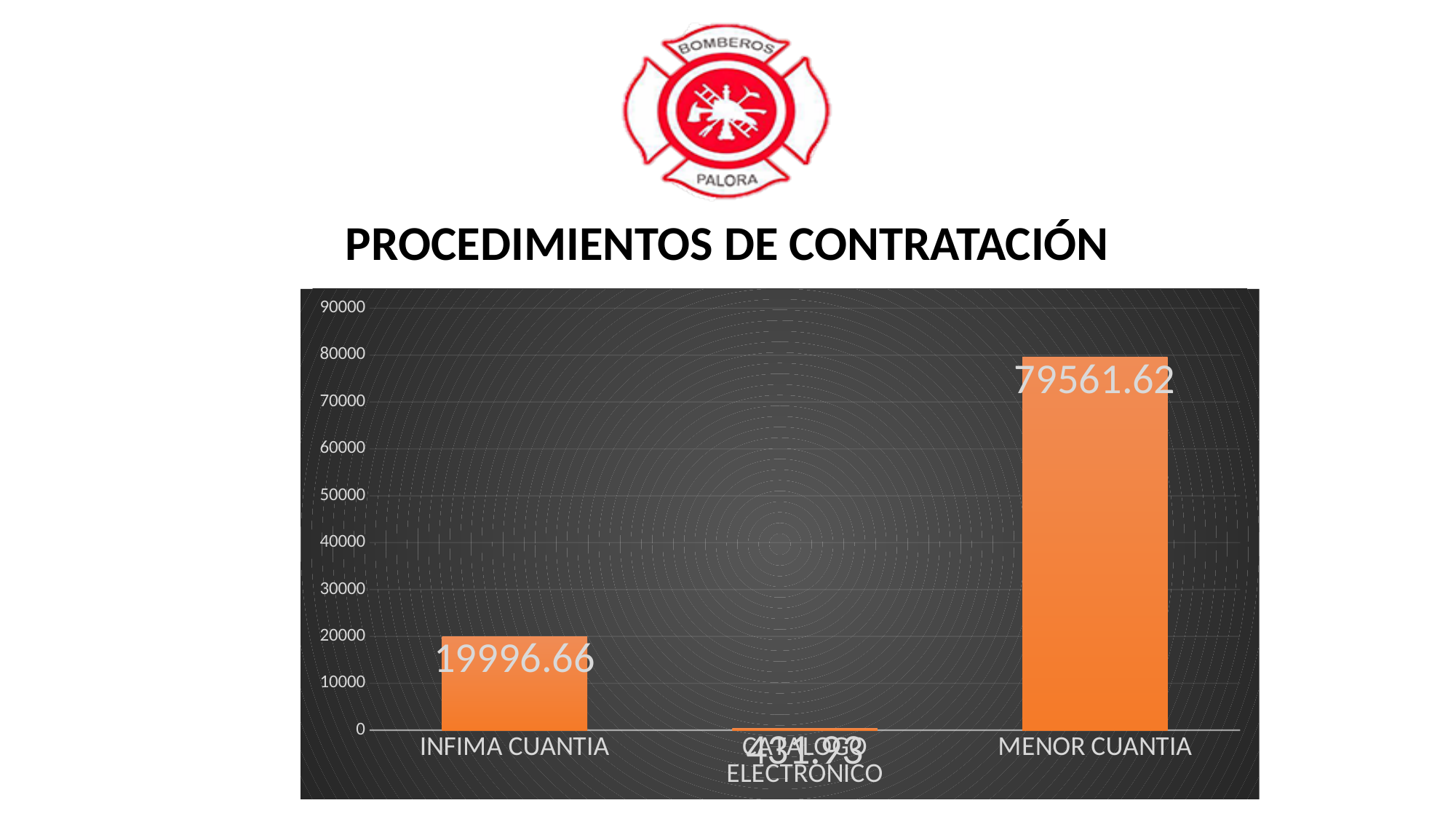
Which category has the highest value? MENOR CUANTIA Which is larger, the value for INFIMA CUANTIA or the value for MENOR CUANTIA? MENOR CUANTIA What is the title shown above the chart? PROCEDIMIENTOS DE CONTRATACIÓN How many categories are shown in the chart? 3 Is the value for INFIMA CUANTIA greater or less than 30000? less Which category has the lowest value? CATALOGO ELECTRONICO What is the value for MENOR CUANTIA? 79561.62 Is the value for MENOR CUANTIA greater or less than 70000? greater What is the value for INFIMA CUANTIA? 19996.66 What is the value shown for the middle bar, CATALOGO ELECTRONICO? 431.93 What kind of chart is shown on the slide? bar chart What is the difference between the values for MENOR CUANTIA and INFIMA CUANTIA? 59564.96